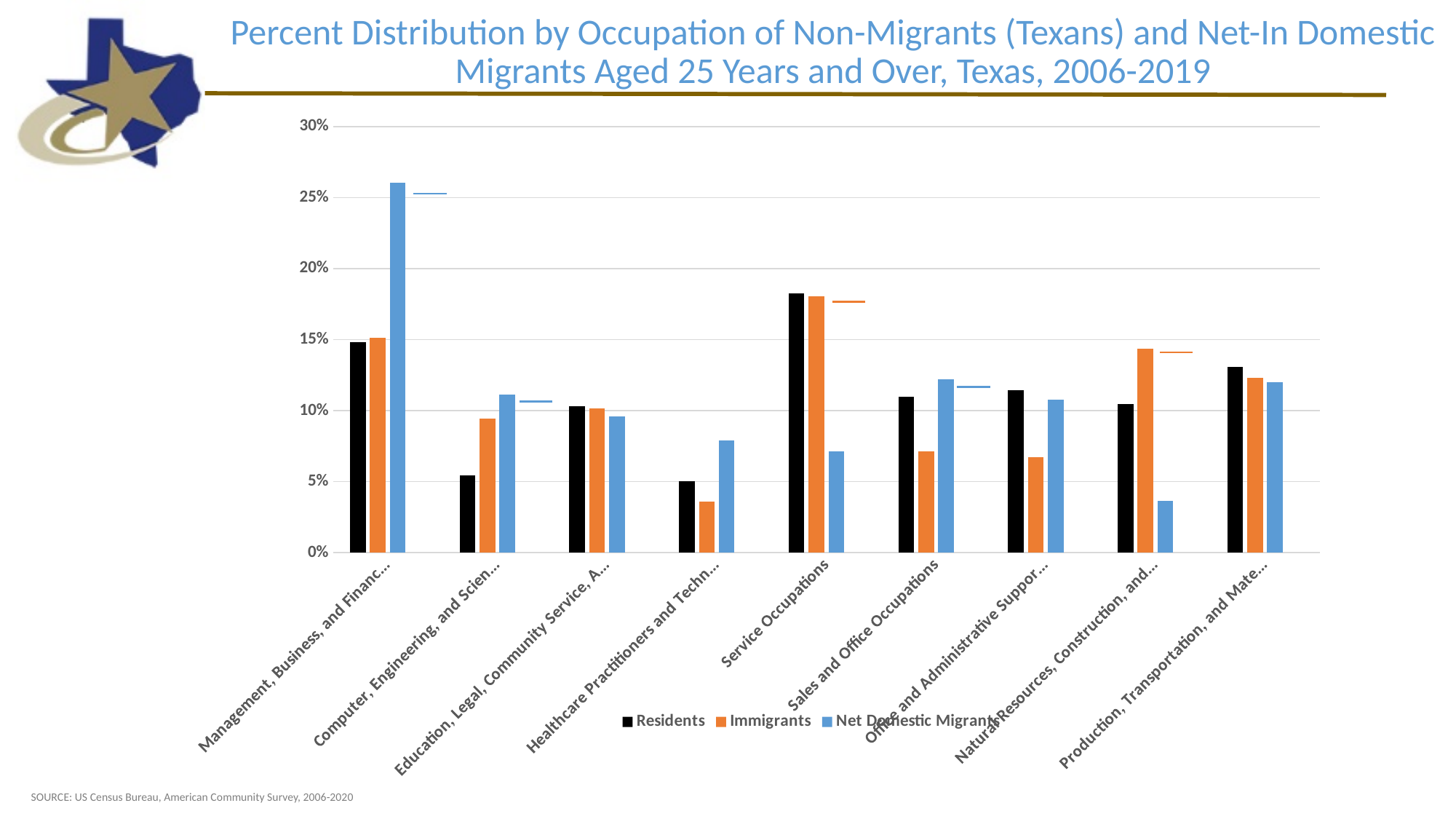
For Service Occupations, which series has the lowest value? Net Domestic Migrants How many occupation categories are plotted along the x axis? 9 Is the Net Domestic Migrants value for Service Occupations greater or less than 10%? less What kind of chart is shown on the slide? bar chart What source is cited at the bottom of the slide? US Census Bureau, American Community Survey, 2006-2020 Is the Residents value for Service Occupations greater or less than 15%? greater Is the Immigrants value for Sales and Office Occupations greater or less than 10%? less For Sales and Office Occupations, which is larger: the Immigrants value or the Net Domestic Migrants value? Net Domestic Migrants How many series does the legend list? 3 Which colour represents the Immigrants series in the legend? orange Which occupation category has the highest value for Residents? Service Occupations